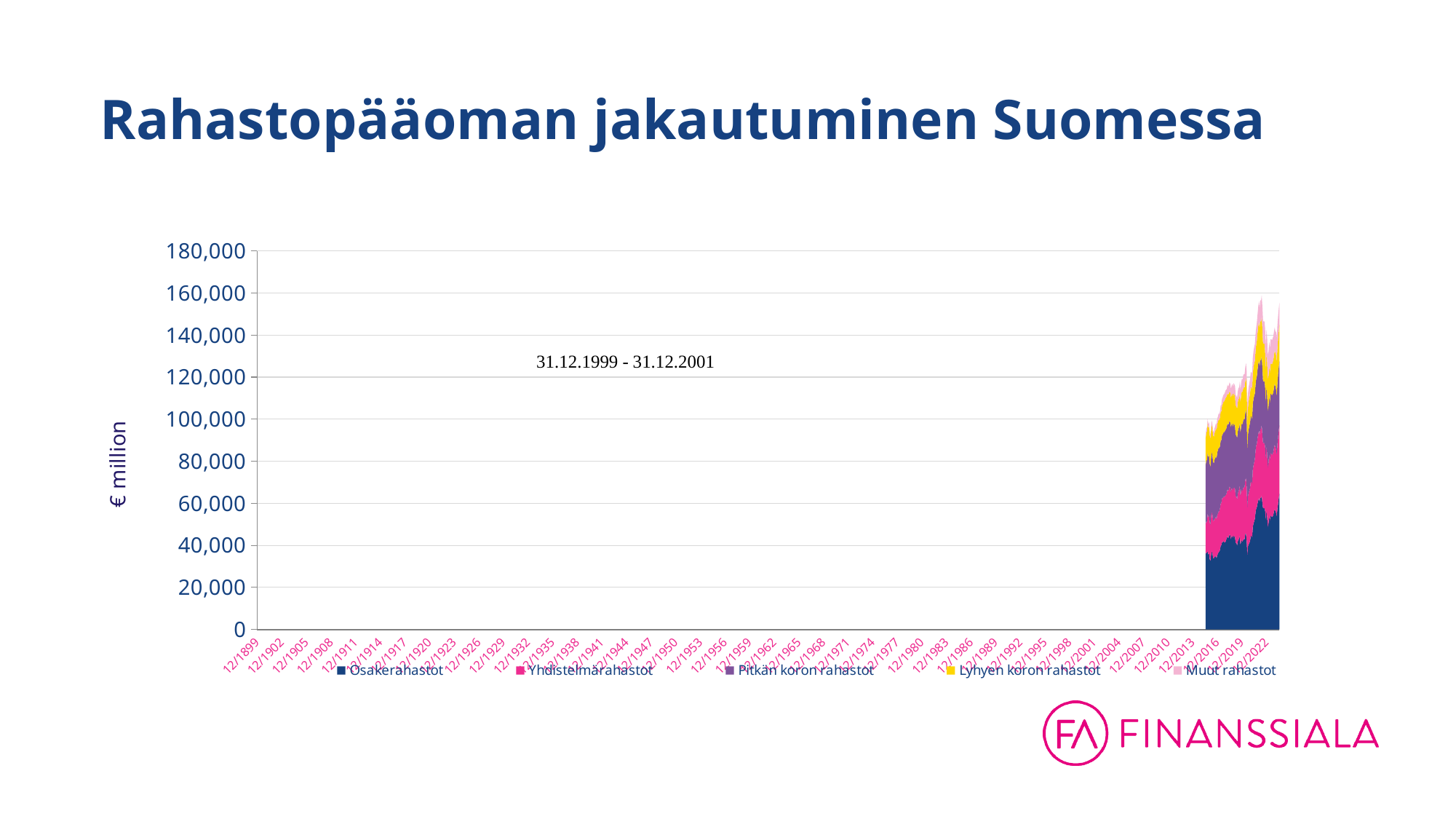
At the right end of the chart, which is larger: Osakerahastot or Lyhyen koron rahastot? Osakerahastot Which series is shown in dark blue at the bottom of the stack? Osakerahastot Does the total fund capital generally rise or fall over the period where data is plotted? rise What is the title of the chart? Rahastopääoman jakautuminen Suomessa What kind of chart is shown on the slide? Stacked area chart How many series does the legend list? 5 What is the label on the vertical axis? € million What is the highest value shown on the vertical axis? 180,000 Is the total fund capital at the end of the series (12/2022) greater or less than 100,000? greater What is the first date label on the horizontal axis? 12/1899 Is the peak total fund capital shown on the chart greater or less than 140,000? greater Which series contributes the largest share of the total at the right end of the chart? Osakerahastot